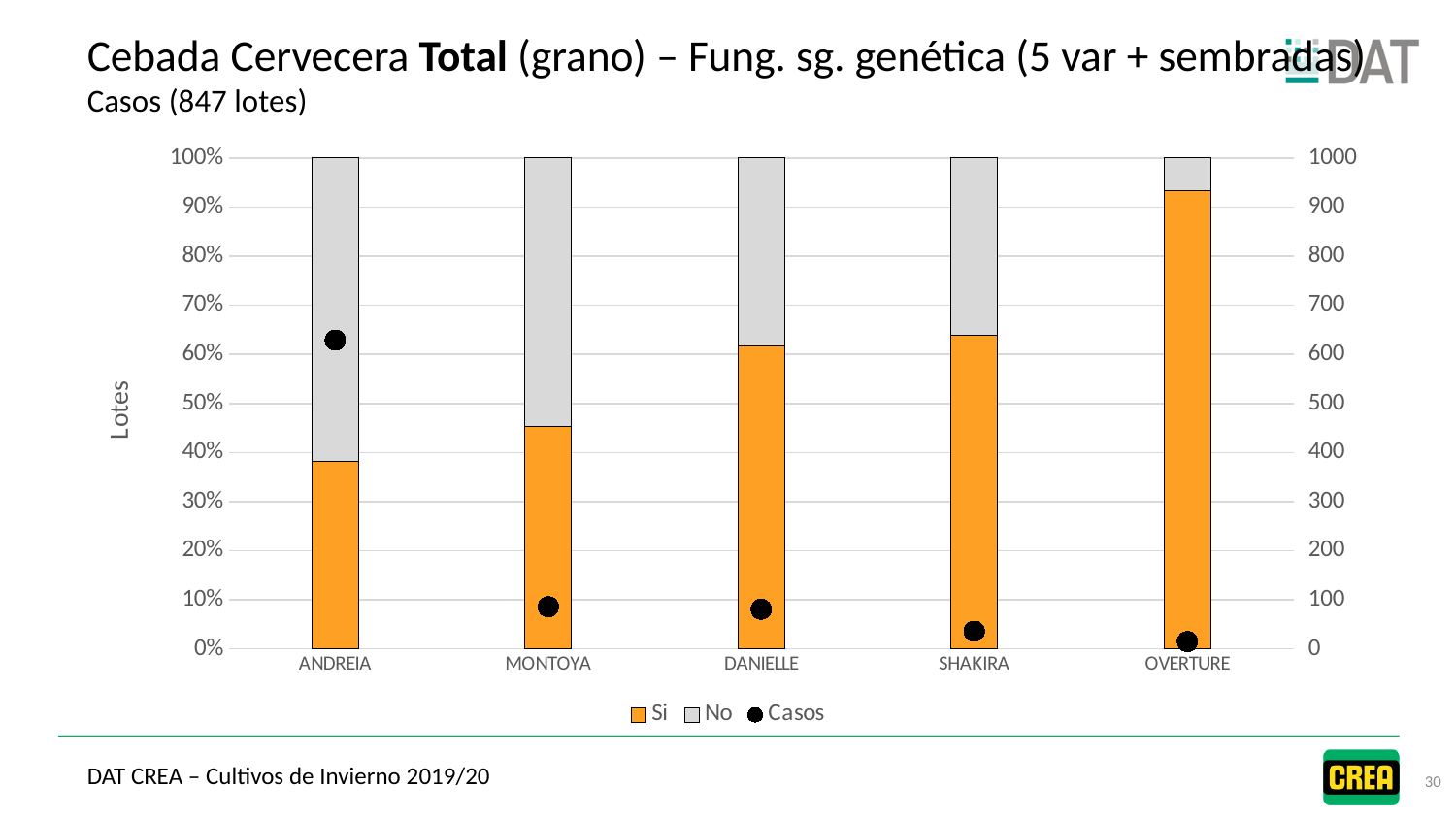
How many varieties (categories) are shown on the x axis? 5 Which has a larger 'Si' share, ANDREIA or MONTOYA? MONTOYA Is the number of 'Casos' for ANDREIA greater or less than 600? greater What kind of chart is shown on the slide? a combination chart: 100% stacked bar chart with 'Casos' plotted as points (dots) Which variety has the highest share of 'Si'? OVERTURE How many series does the legend list? 3 Which variety has the highest number of 'Casos'? ANDREIA Is the 'Si' share for ANDREIA greater or less than 40%? less Which variety has the lowest share of 'Si'? ANDREIA Is the 'Si' share for OVERTURE greater or less than 90%? greater What are the three entries listed in the chart legend? Si, No, Casos